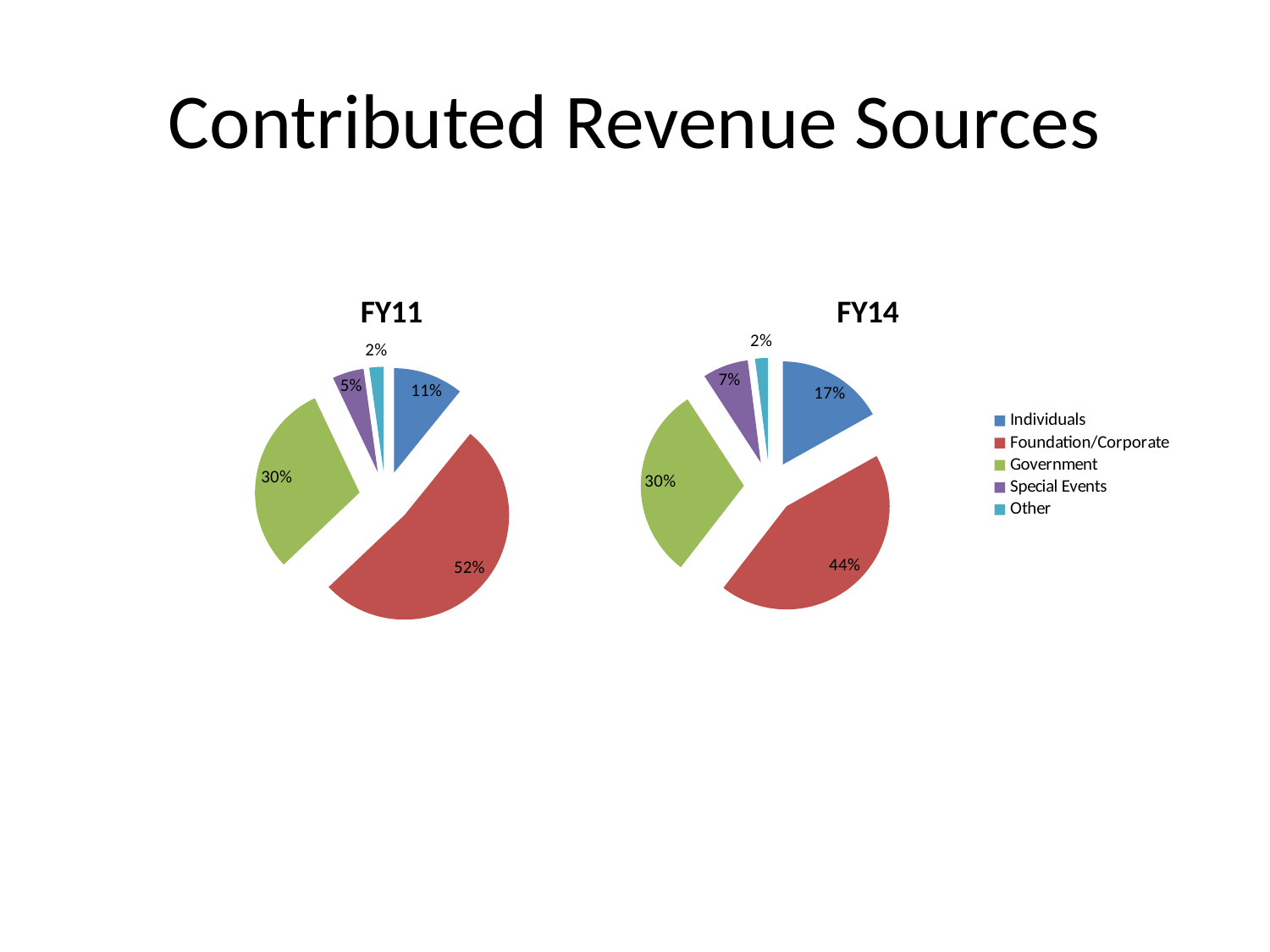
In the FY11 pie chart, what share does Government have? 30% In the FY11 pie chart, which category has the largest share? Foundation/Corporate Which is larger: the Individuals share in FY11 or in FY14? FY14 What type of chart is used for FY11 and FY14? Pie chart In the FY11 pie chart, what share does Foundation/Corporate have? 52% How many categories does the legend list? 5 In the FY14 pie chart, what share does Special Events have? 7% What is the difference between the Foundation/Corporate share in FY11 and in FY14? 8% In the FY14 pie chart, which category has the smallest share? Other In the FY14 pie chart, what is the difference between the Government share and the Special Events share? 23% In the FY14 pie chart, what share does Individuals have? 17% Which colour represents Government in the legend? Green